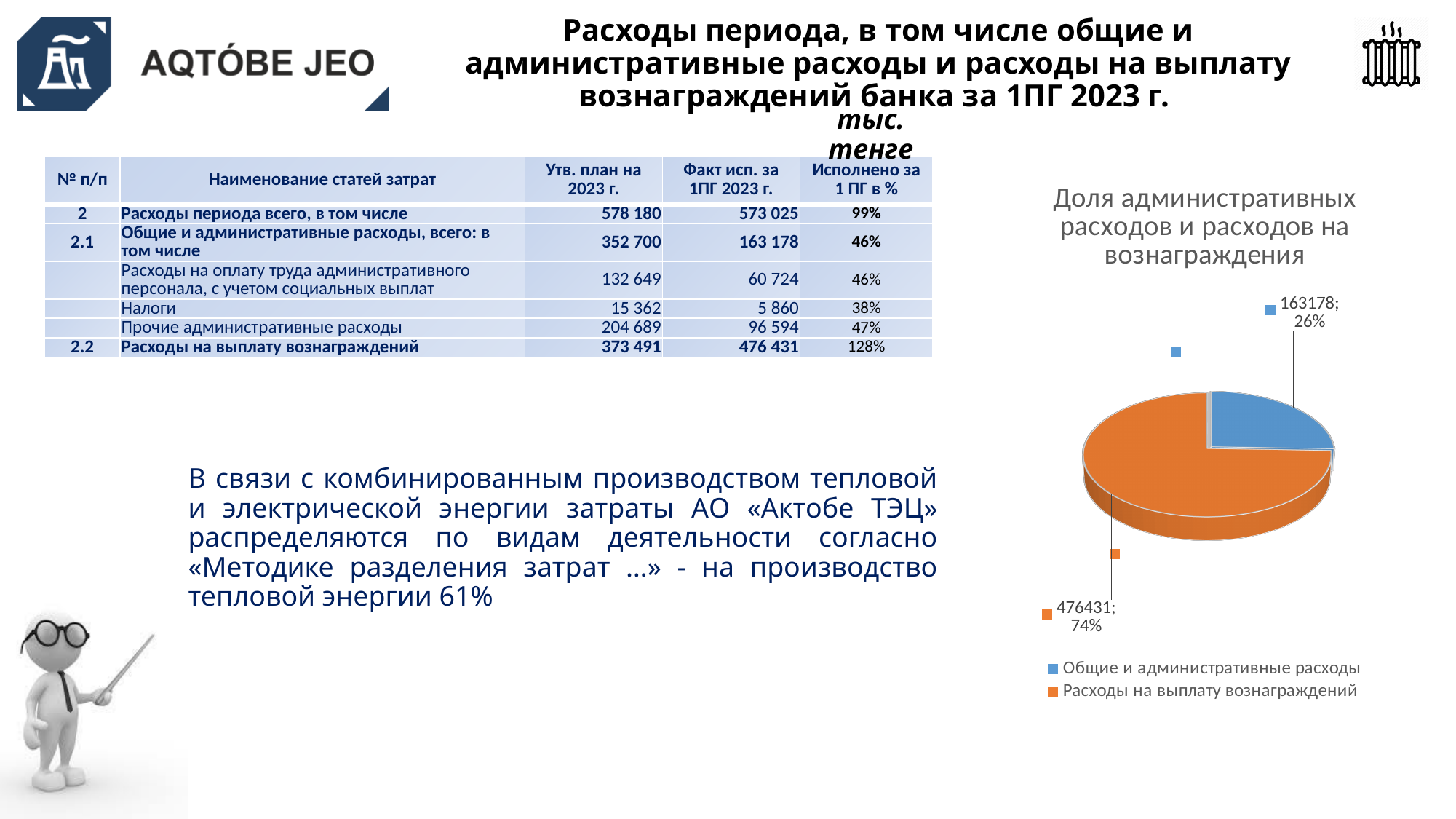
What is the difference between the values for Расходы на выплату вознаграждений and Общие и административные расходы in the pie chart? 313253 How many slices does the pie chart have? 2 Which slice of the pie chart is the smallest? Общие и административные расходы How many entries does the legend of the pie chart list? 2 What type of chart is shown on the slide? pie chart What value is shown for Расходы на выплату вознаграждений in the pie chart? 476431 Which slice of the pie chart is the largest? Расходы на выплату вознаграждений What share of the pie does Общие и административные расходы represent? 26% What share of the pie does Расходы на выплату вознаграждений represent? 74% What value is shown for Общие и административные расходы in the pie chart? 163178 What is the title of the pie chart? Доля административных расходов и расходов на вознаграждения Which colour represents Расходы на выплату вознаграждений in the pie chart? orange